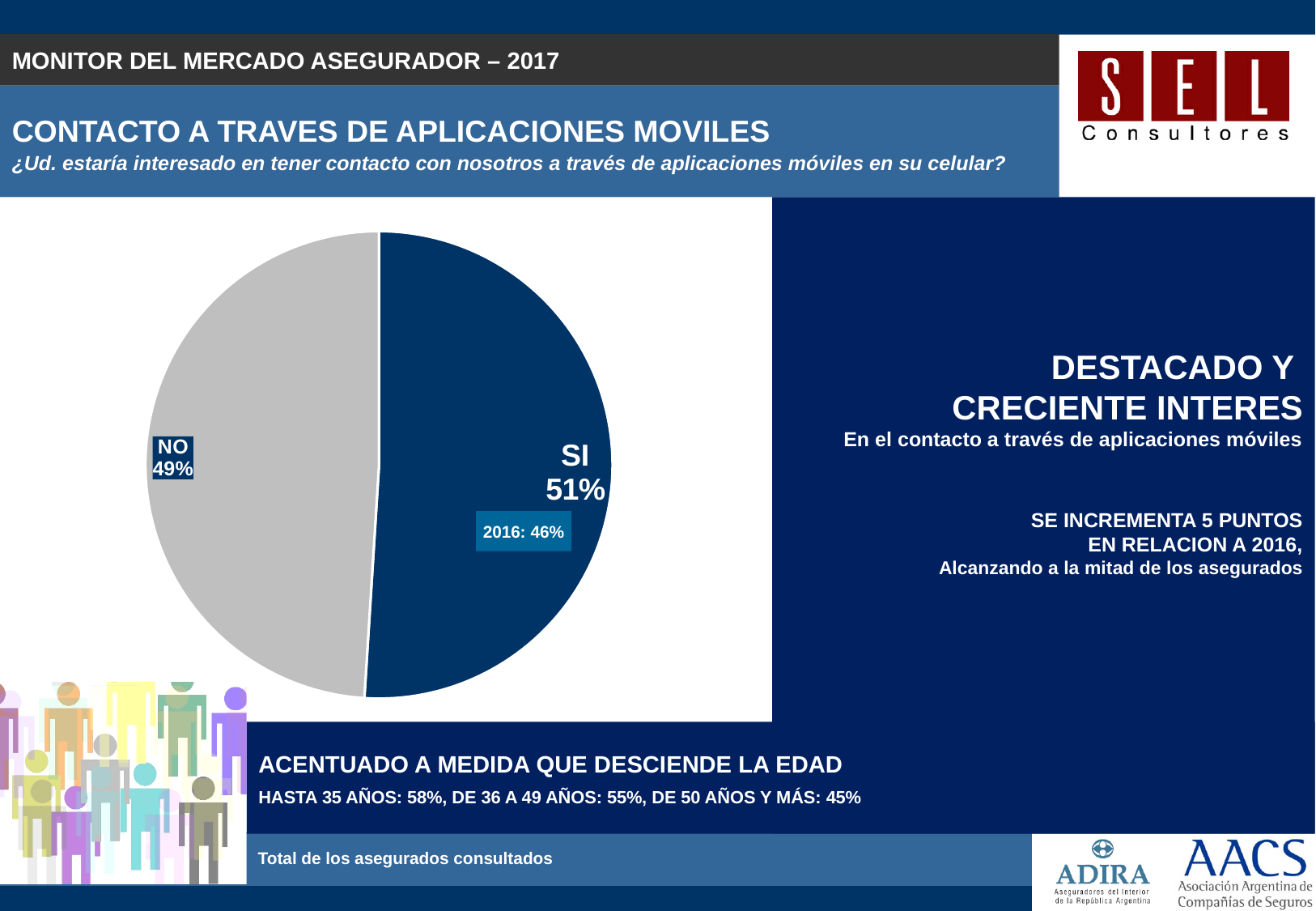
What colour is the SI slice of the pie chart? dark blue What was the SI value in 2016, as shown on the chart? 46% Which response has the largest share of the pie? SI How many slices does the pie chart have? 2 What percentage of respondents answered NO? 49% What percentage of respondents answered SI? 51% Which response has the smallest share of the pie? NO What is the difference in percentage points between the SI and NO slices? 2 By how many percentage points did the SI share increase from 2016 to 2017? 5 Which slice is larger, SI or NO? SI What colour is the NO slice of the pie chart? grey What kind of chart is shown on the slide? pie chart